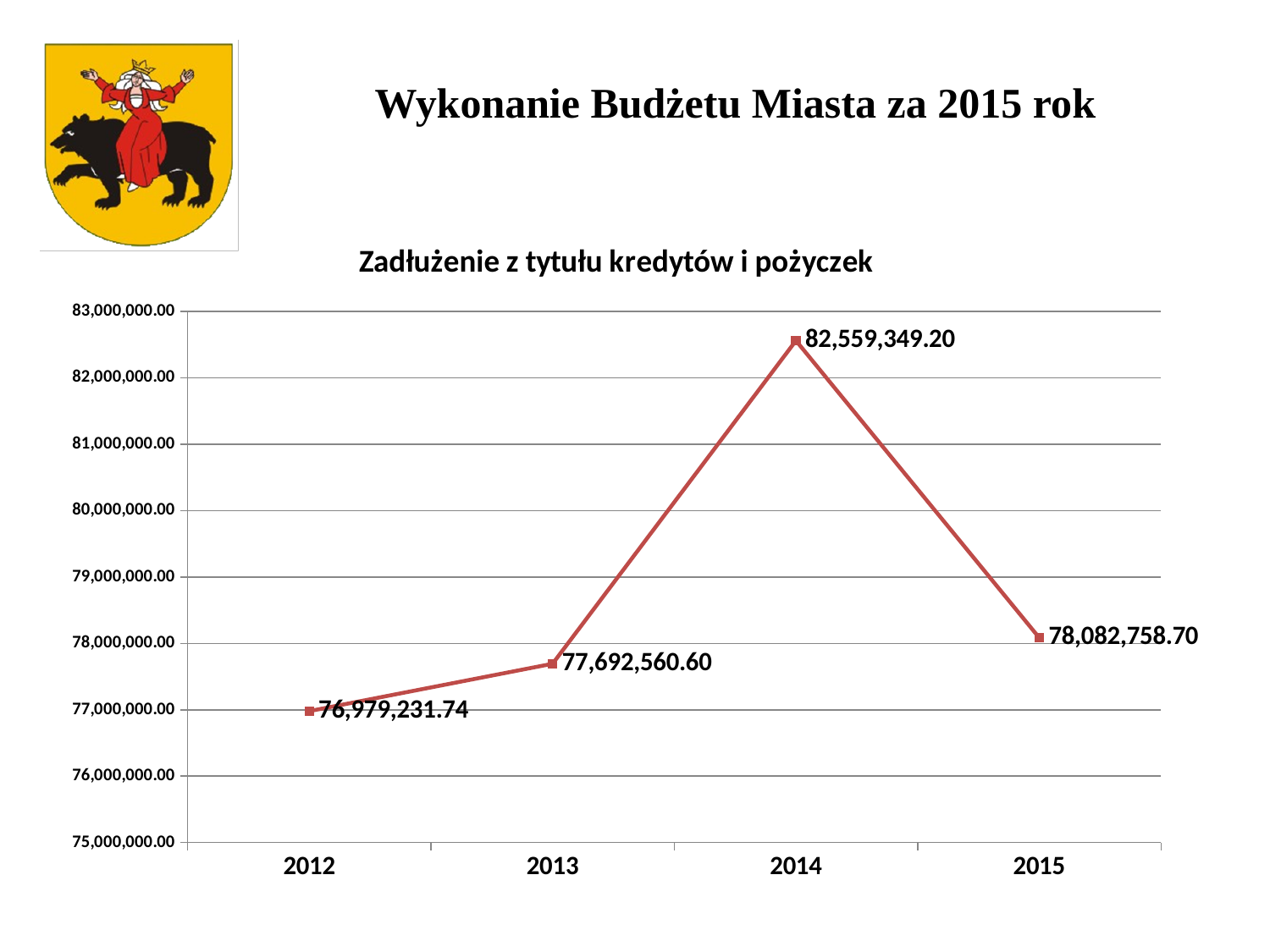
Which year has the lowest value in the chart? 2012 What is the difference between the values for 2014 and 2015? 4,476,590.50 What is the difference between the values for 2014 and 2013? 4,866,788.60 How many years are plotted in the chart? 4 What is the value for 2013 in the chart? 77,692,560.60 Is the value for 2014 greater or less than 82,000,000.00? greater What is the value for 2015 in the chart? 78,082,758.70 Which is larger, the value for 2015 or the value for 2013? 2015 Which year has the highest value in the chart? 2014 What kind of chart is shown on the slide? line chart What is the value for 2012 in the chart? 76,979,231.74 What is the value for 2014 in the chart? 82,559,349.20